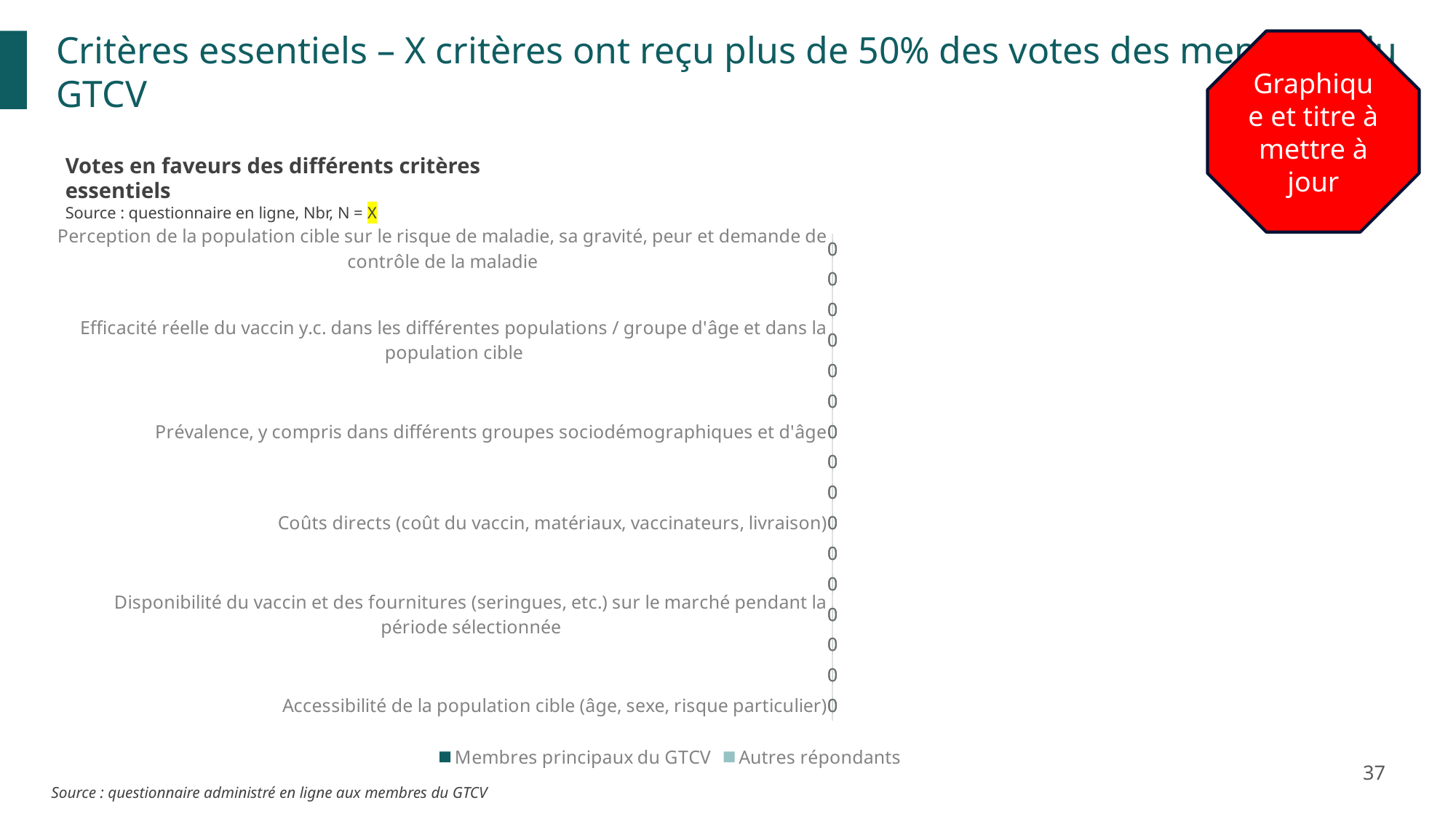
What value is shown for 'Membres principaux du GTCV' for the category 'Coûts directs (coût du vaccin, matériaux, vaccinateurs, livraison)'? 0 How many series does the chart legend list? 2 What are the two series named in the chart legend? Membres principaux du GTCV; Autres répondants What value is shown for 'Autres répondants' for the category 'Disponibilité du vaccin et des fournitures (seringues, etc.) sur le marché pendant la période sélectionnée'? 0 What value is shown for 'Autres répondants' for the category 'Accessibilité de la population cible (âge, sexe, risque particulier)'? 0 What kind of chart is shown on the slide? bar chart What is the title of the chart? Votes en faveurs des différents critères essentiels What value is shown for 'Membres principaux du GTCV' for the category 'Prévalence, y compris dans différents groupes sociodémographiques et d'âge'? 0